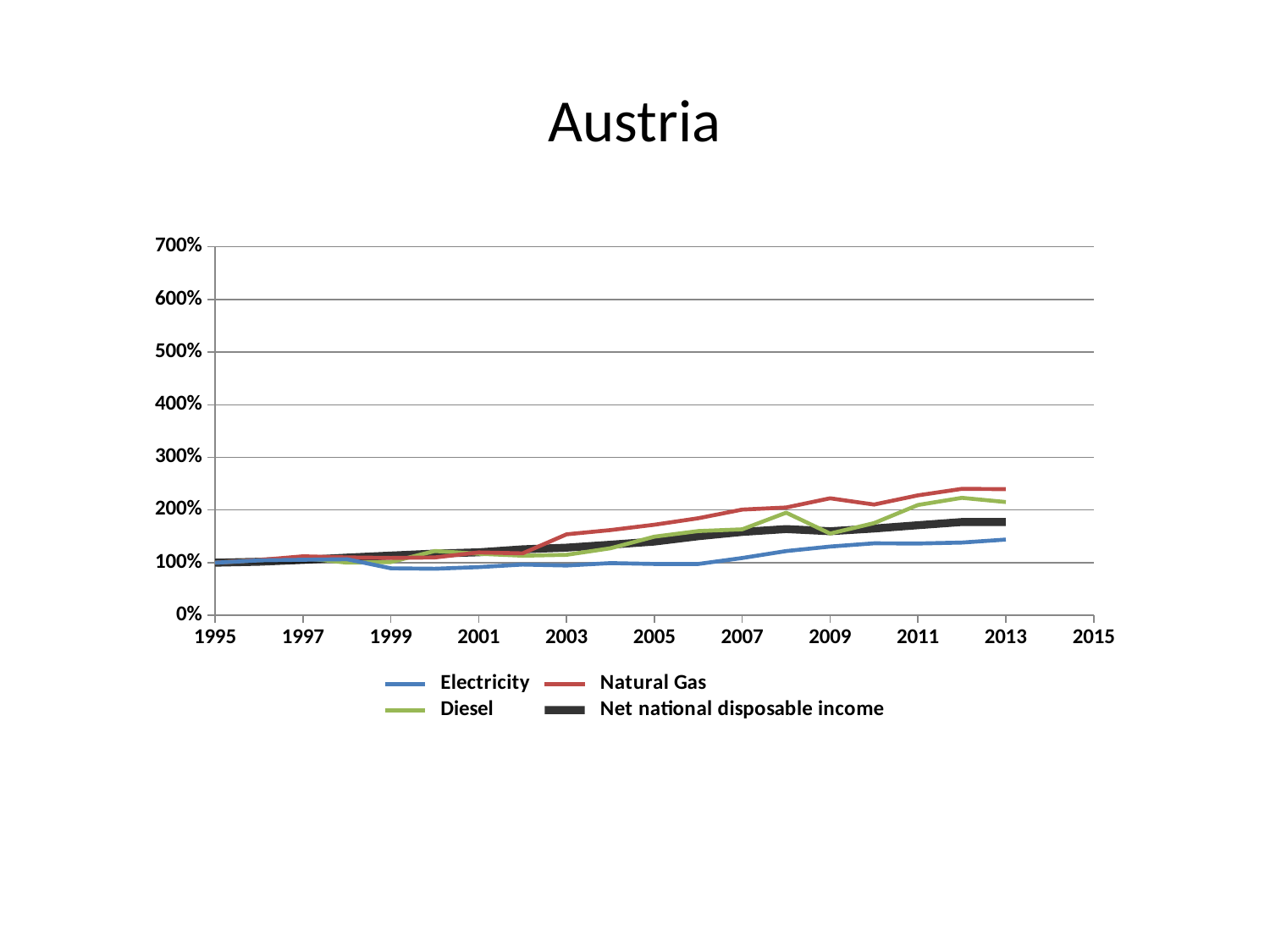
What kind of chart is shown on the slide? line chart Which series has the lowest value in 2013? Electricity Is the value for Net national disposable income in 2013 greater or less than 100%? greater What is the title of the chart? Austria Is the value for Electricity in 2013 greater or less than 200%? less Which series are listed in the legend? Electricity, Natural Gas, Diesel, Net national disposable income Which series has the highest value in 2013? Natural Gas How many series does the legend list? 4 Does the Natural Gas series rise or fall from 1995 to 2013? rise In 2009, which is larger: Natural Gas or Diesel? Natural Gas Is the value for Natural Gas in 2013 greater or less than 200%? greater In 2013, which is larger: Natural Gas or Electricity? Natural Gas